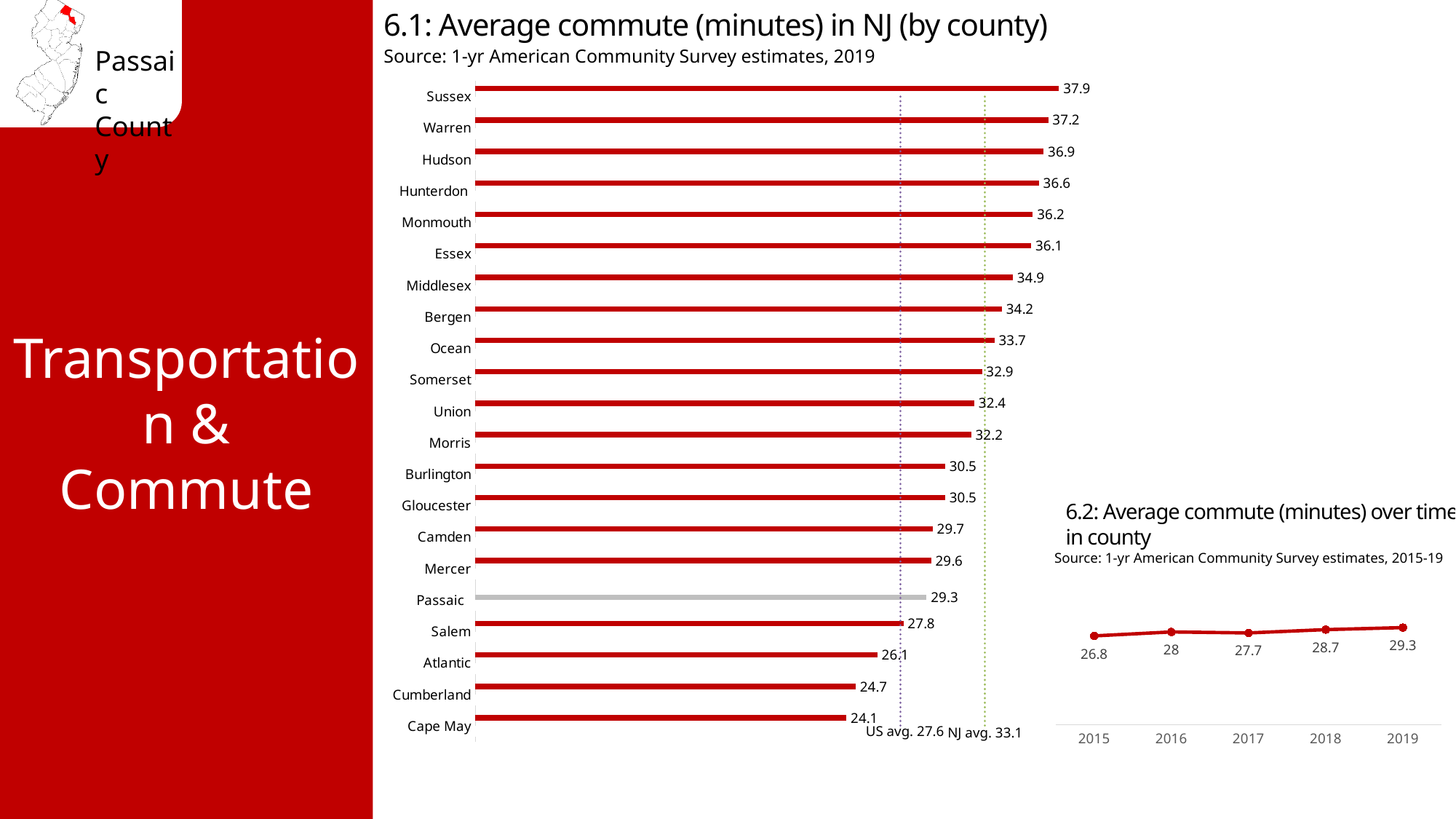
In chart 6.1 (Average commute in NJ by county), which county has the lowest average commute? Cape May In chart 6.2 (Average commute over time in county), what is the value for 2017? 27.7 In chart 6.1 (Average commute in NJ by county), how many counties are shown? 21 In chart 6.1 (Average commute in NJ by county), what is the average commute for Passaic? 29.3 In chart 6.1 (Average commute in NJ by county), what is the NJ average shown by the dotted reference line? 33.1 In chart 6.1 (Average commute in NJ by county), which is larger, the value for Bergen or the value for Ocean? Bergen In chart 6.2 (Average commute over time in county), what is the difference between the 2019 and 2015 values? 2.5 In chart 6.1 (Average commute in NJ by county), what is the average commute for Hudson? 36.9 In chart 6.1 (Average commute in NJ by county), which county has the highest average commute? Sussex In chart 6.1 (Average commute in NJ by county), what is the difference between Sussex and Cape May? 13.8 In chart 6.2 (Average commute over time in county), which year has the lowest value? 2015 What kind of chart is chart 6.1 (Average commute in NJ by county)? Bar chart